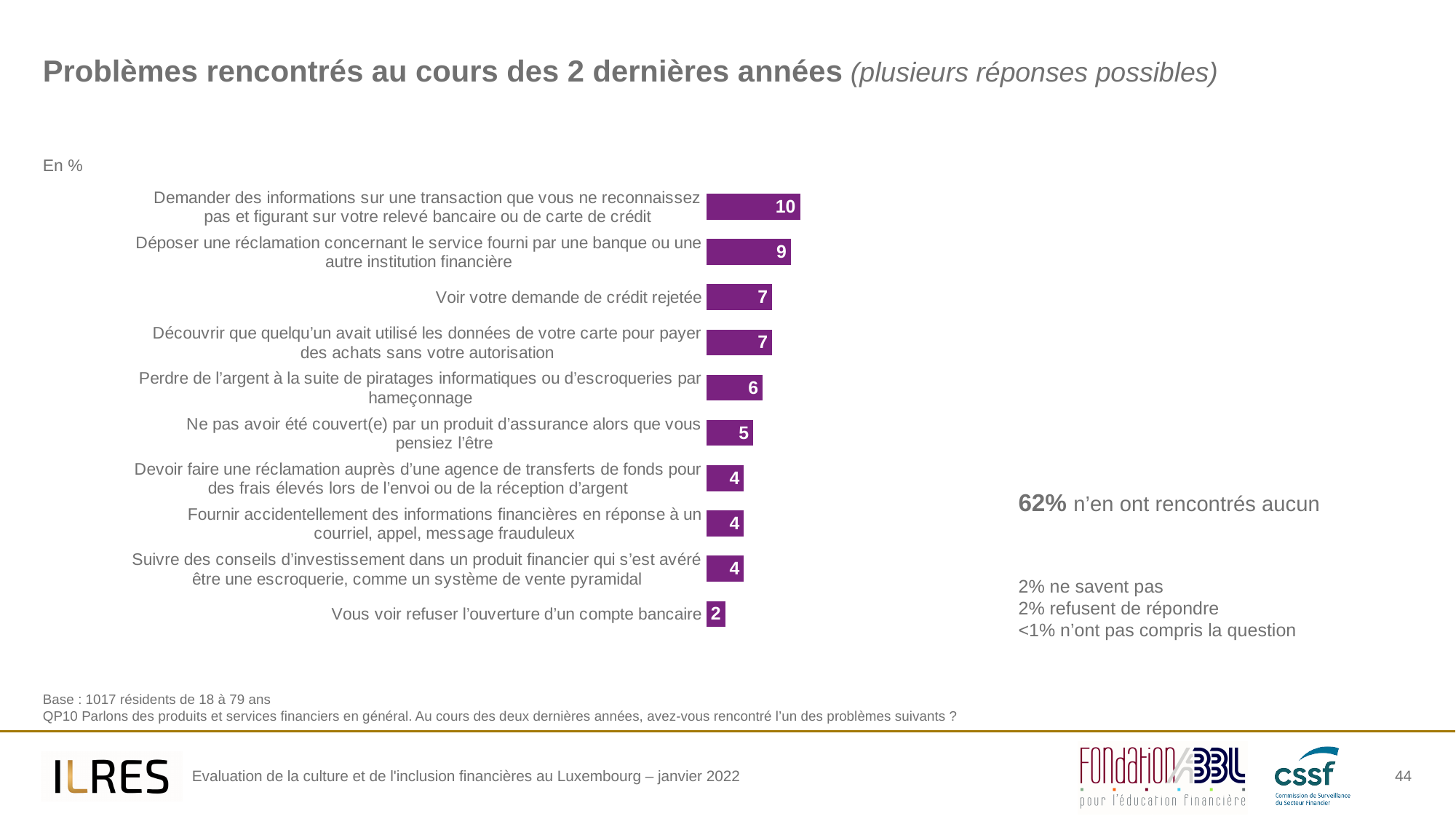
What type of chart is shown on the slide? Bar chart According to the text next to the chart, what percentage of respondents encountered none of the problems? 62% What percentage of respondents reported asking for information about a transaction they did not recognise on their bank or credit card statement? 10 Which is larger: the value for "Ne pas avoir été couvert(e) par un produit d'assurance alors que vous pensiez l'être" or the value for "Vous voir refuser l'ouverture d'un compte bancaire"? Ne pas avoir été couvert(e) par un produit d'assurance alors que vous pensiez l'être How many categories have a value of 4? 3 Which problem has the lowest value in the chart? Vous voir refuser l'ouverture d'un compte bancaire What is the difference between the value for "Déposer une réclamation concernant le service fourni par une banque ou une autre institution financière" and the value for "Perdre de l'argent à la suite de piratages informatiques ou d'escroqueries par hameçonnage"? 3 How many problem categories are shown in the chart? 10 What is the value for "Voir votre demande de crédit rejetée"? 7 In what unit are the chart values expressed, according to the label above the chart? En % Which problem has the highest value in the chart? Demander des informations sur une transaction que vous ne reconnaissez pas et figurant sur votre relevé bancaire ou de carte de crédit What is the value for "Vous voir refuser l'ouverture d'un compte bancaire"? 2